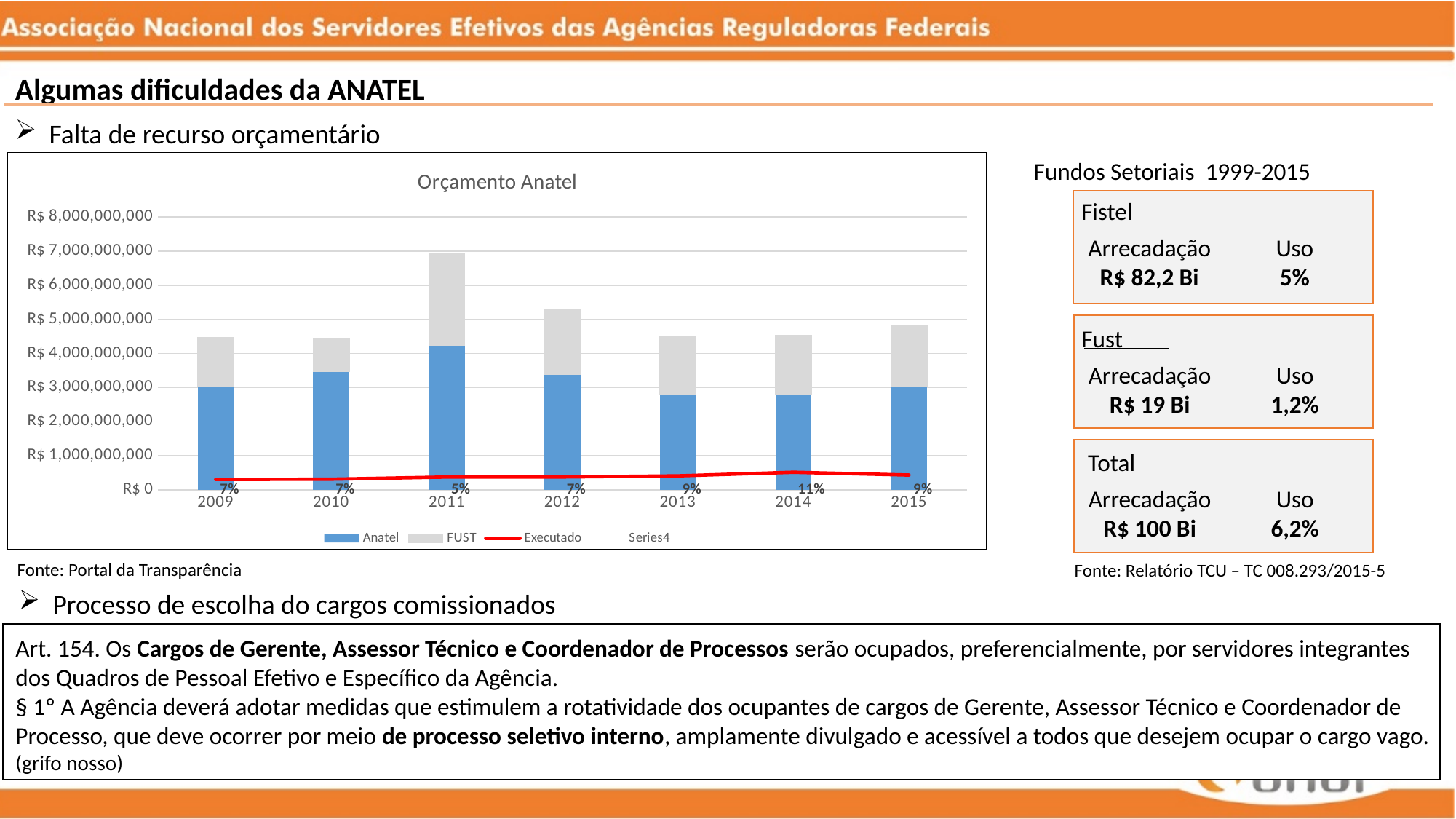
In the Orçamento Anatel chart, which year has the lowest percentage label? 2011 In the Orçamento Anatel chart, which year has the tallest stacked bar? 2011 In the Orçamento Anatel chart, is the Anatel (blue) value for 2011 greater or less than R$ 4,000,000,000? greater In the Orçamento Anatel chart, is the total stacked bar for 2012 greater or less than R$ 5,000,000,000? greater What kind of chart is the Orçamento Anatel chart? Stacked bar chart with a line How many series does the legend of the Orçamento Anatel chart list? 4 In the Orçamento Anatel chart, what percentage label is shown for 2011? 5% In the Orçamento Anatel chart, what percentage label is shown for 2014? 11% What is the title of the chart on the left of the slide? Orçamento Anatel In the Orçamento Anatel chart, how many years are shown on the x axis? 7 In the Orçamento Anatel chart, which year has the highest percentage label? 2014 In the Orçamento Anatel chart, which year has the largest Anatel (blue) segment? 2011